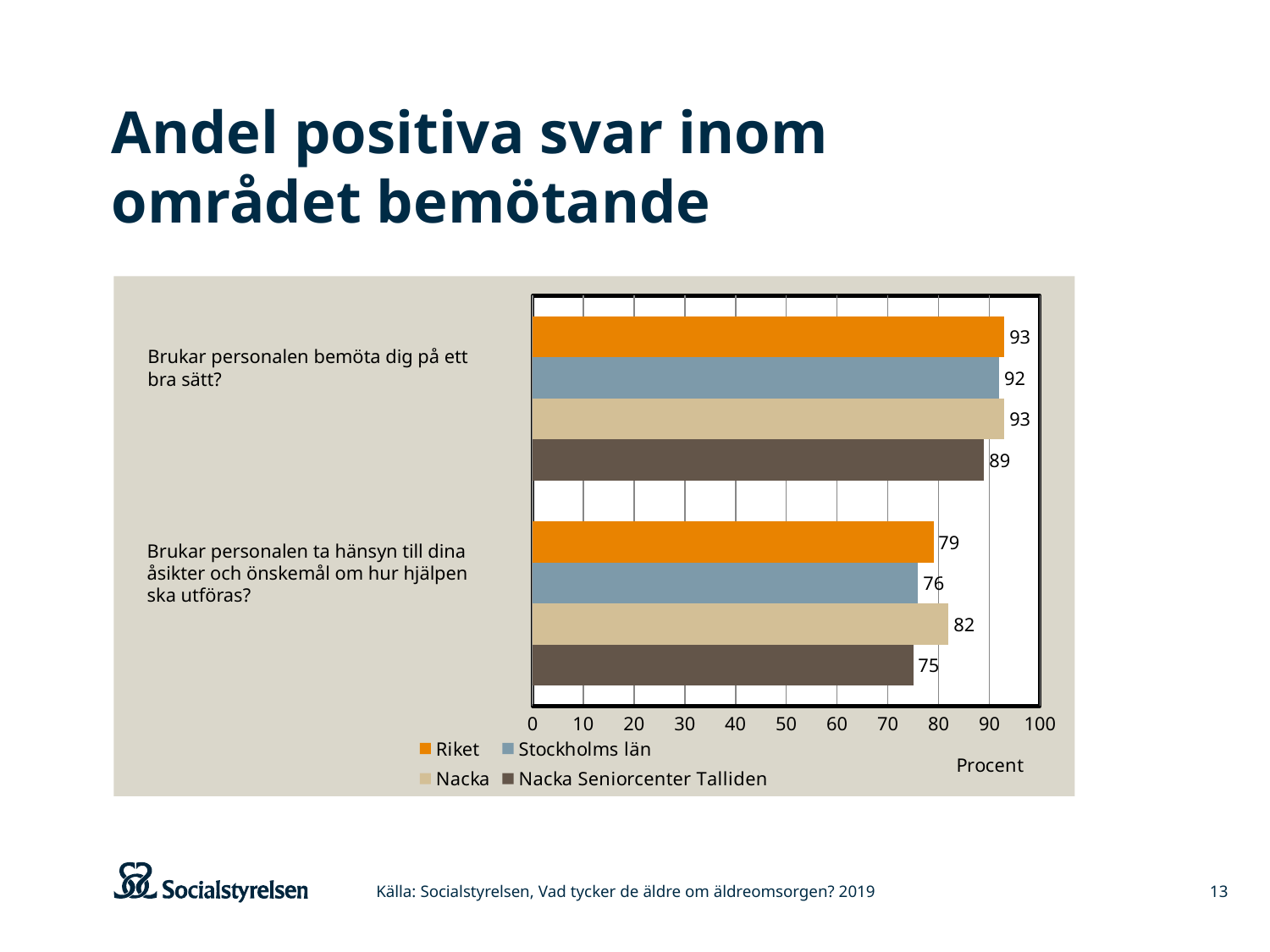
What unit is shown on the horizontal axis of the chart? Procent What kind of chart is shown on the slide? bar chart Which is larger for Nacka Seniorcenter Talliden: the value for "Brukar personalen bemöta dig på ett bra sätt?" or for "Brukar personalen ta hänsyn till dina åsikter och önskemål om hur hjälpen ska utföras?"? Brukar personalen bemöta dig på ett bra sätt? What is the value for Stockholms län on the question "Brukar personalen ta hänsyn till dina åsikter och önskemål om hur hjälpen ska utföras?"? 76 Which series has the lowest value on the question "Brukar personalen bemöta dig på ett bra sätt?"? Nacka Seniorcenter Talliden How many questions (categories) are shown in the chart? 2 What is the value for Nacka Seniorcenter Talliden on the question "Brukar personalen ta hänsyn till dina åsikter och önskemål om hur hjälpen ska utföras?"? 75 Which series has the highest value on the question "Brukar personalen ta hänsyn till dina åsikter och önskemål om hur hjälpen ska utföras?"? Nacka What is the difference between Nacka and Nacka Seniorcenter Talliden on the question "Brukar personalen ta hänsyn till dina åsikter och önskemål om hur hjälpen ska utföras?"? 7 How many series does the legend list? 4 Is the value for Riket on the question "Brukar personalen ta hänsyn till dina åsikter och önskemål om hur hjälpen ska utföras?" greater or less than 80? less What is the value for Riket on the question "Brukar personalen bemöta dig på ett bra sätt?"? 93